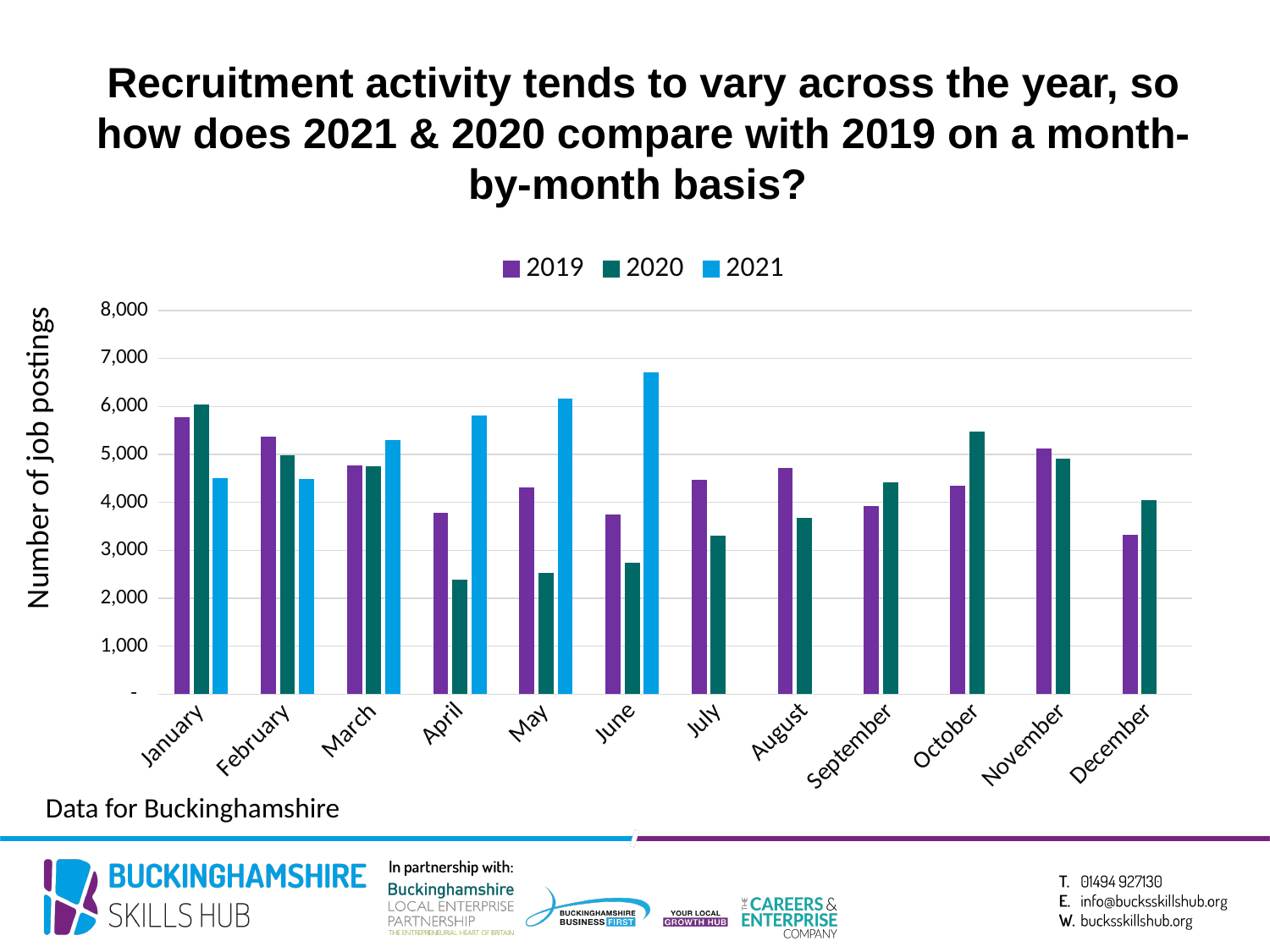
In April, which year has the larger number of job postings, 2020 or 2021? 2021 What kind of chart is shown on the slide? bar chart Is the 2021 value for June greater or less than 6,000? greater Do the 2021 values rise or fall from February to June? rise How many months are shown along the x axis? 12 In which month is the 2019 value lowest? December Is the 2020 value for April greater or less than 3,000? less How many series does the legend list? 3 In which month is the 2020 value lowest? April In which month is the 2021 value highest? June In October, which year has the larger number of job postings, 2019 or 2020? 2020 In which month is the 2019 value highest? January